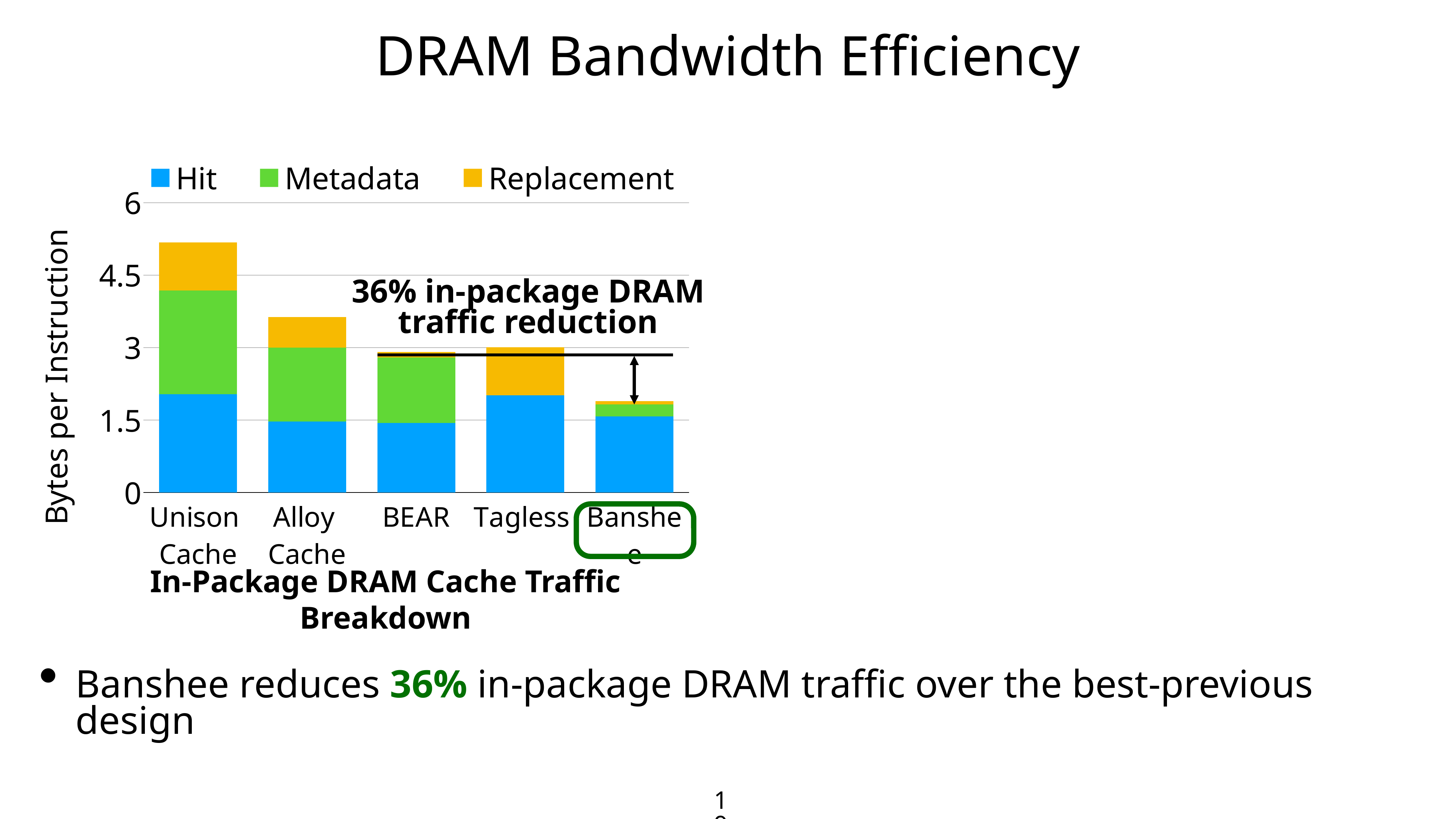
What is the label of the y axis? Bytes per Instruction What kind of chart is shown on the slide? Stacked bar chart How many cache designs (categories) are shown on the x axis? 5 Is the total value for Banshee greater or less than 3? less Which series is shown in orange in the legend? Replacement How many series does the legend list? 3 Which has a larger total bytes per instruction, Unison Cache or Alloy Cache? Unison Cache Is the total value for Banshee greater or less than 1.5? greater Is the total value for Alloy Cache greater or less than 3? greater Which cache design has the lowest total bytes per instruction? Banshee Which cache design has the highest total bytes per instruction? Unison Cache